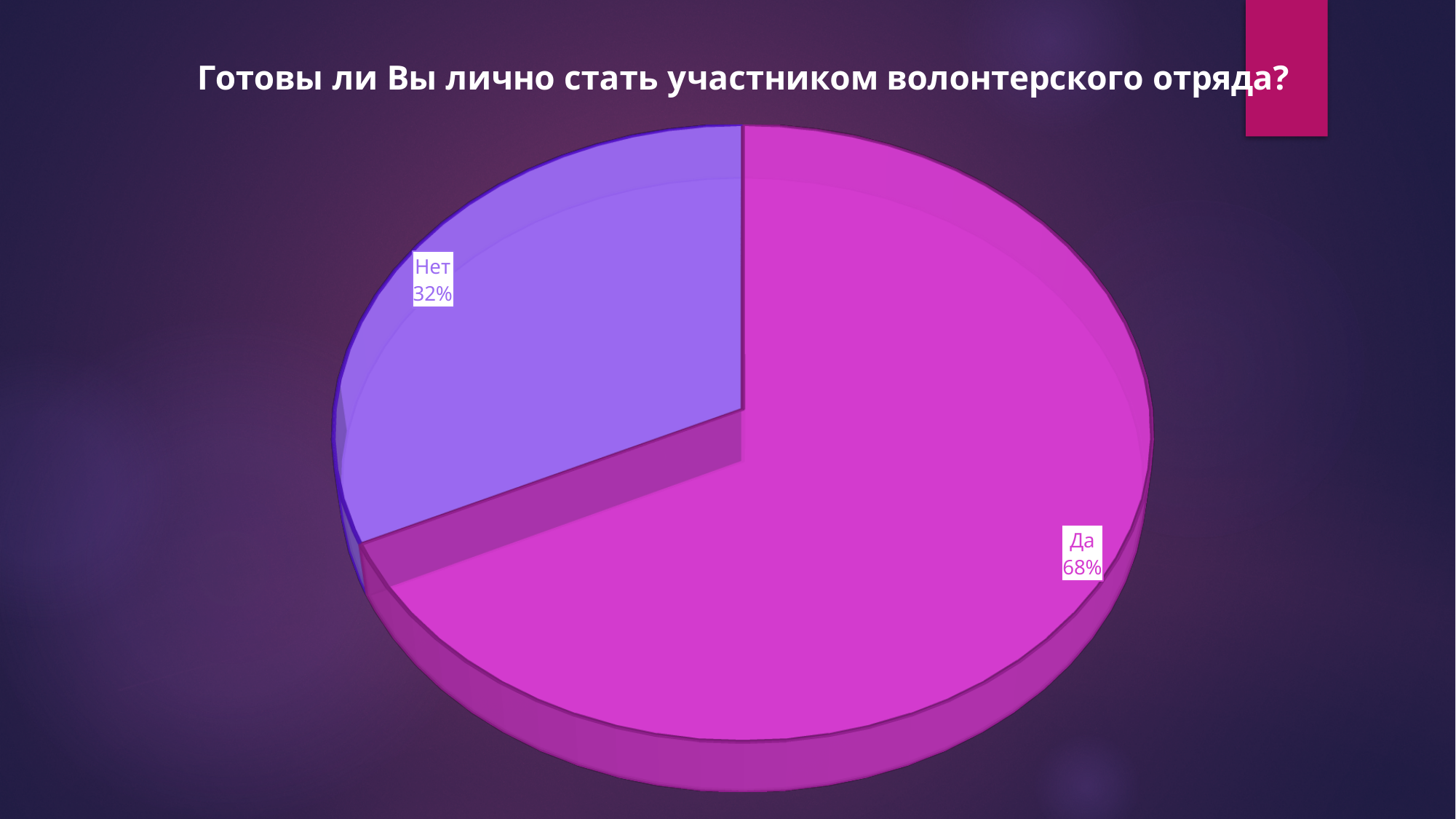
How many slices does the pie chart have? 2 What kind of chart is shown on the slide? Pie chart What share of the pie does the "Нет" slice represent? 32% What share of the pie does the "Да" slice represent? 68% What is the total of the two slice percentages shown? 100% Which slice is the largest in the pie chart? Да What colour is the "Нет" slice? Purple Which slice is the smallest in the pie chart? Нет What is the difference in percentage points between the "Да" and "Нет" slices? 36% What is the title of the chart? Готовы ли Вы лично стать участником волонтерского отряда? Which is larger, the "Да" slice or the "Нет" slice? Да